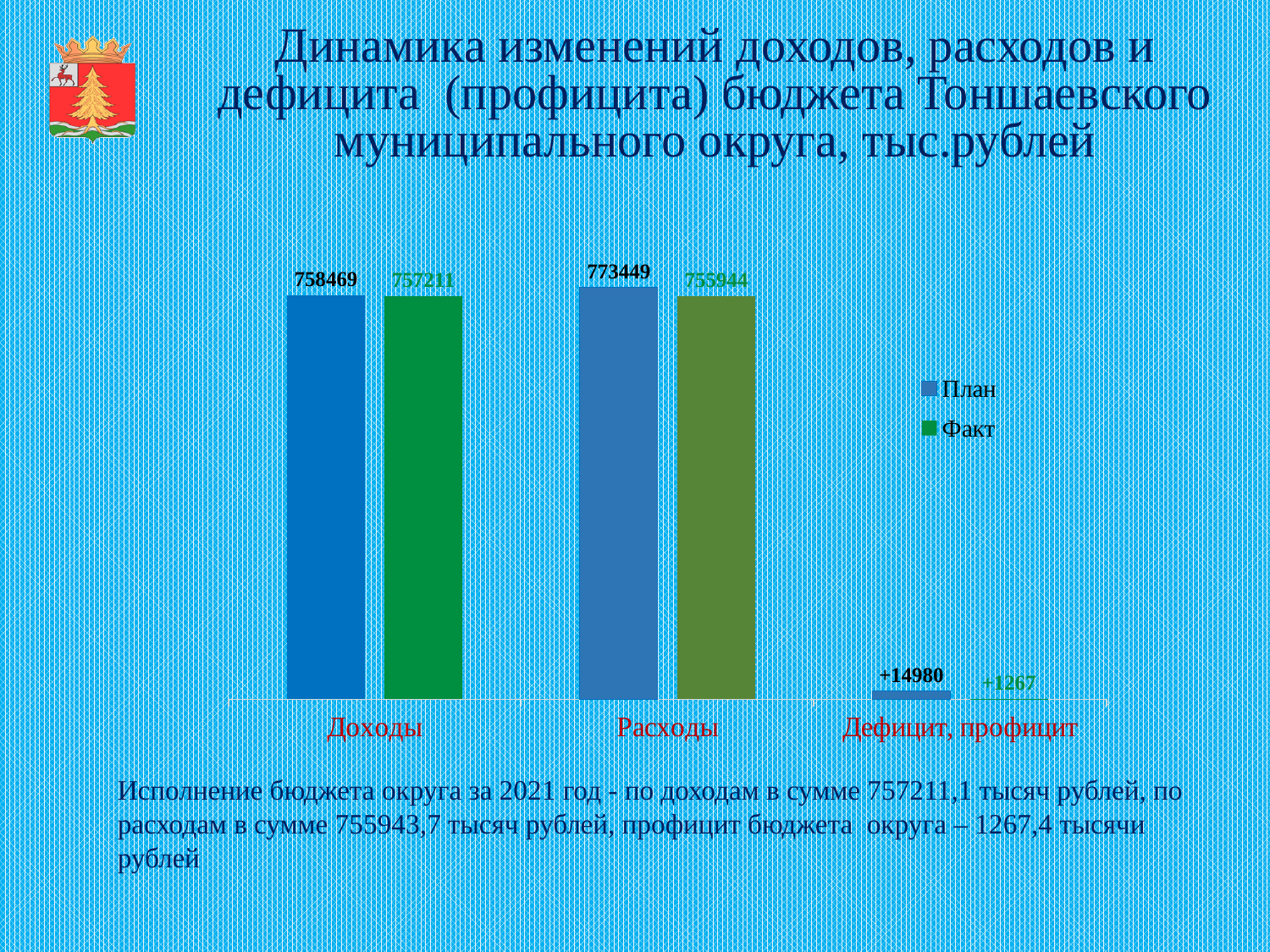
What is the Факт value for Доходы? 757211 What is the План value for Дефицит, профицит? +14980 How many categories are shown on the x axis? 3 What is the difference between the План and Факт values for Расходы? 17505 What kind of chart is shown on the slide? Bar chart How many series does the legend list? 2 What is the План value for Доходы? 758469 What is the План value for Расходы? 773449 Which category has the highest План value? Расходы Which category has the lowest Факт value? Дефицит, профицит What is the Факт value for Расходы? 755944 What is the Факт value for Дефицит, профицит? +1267